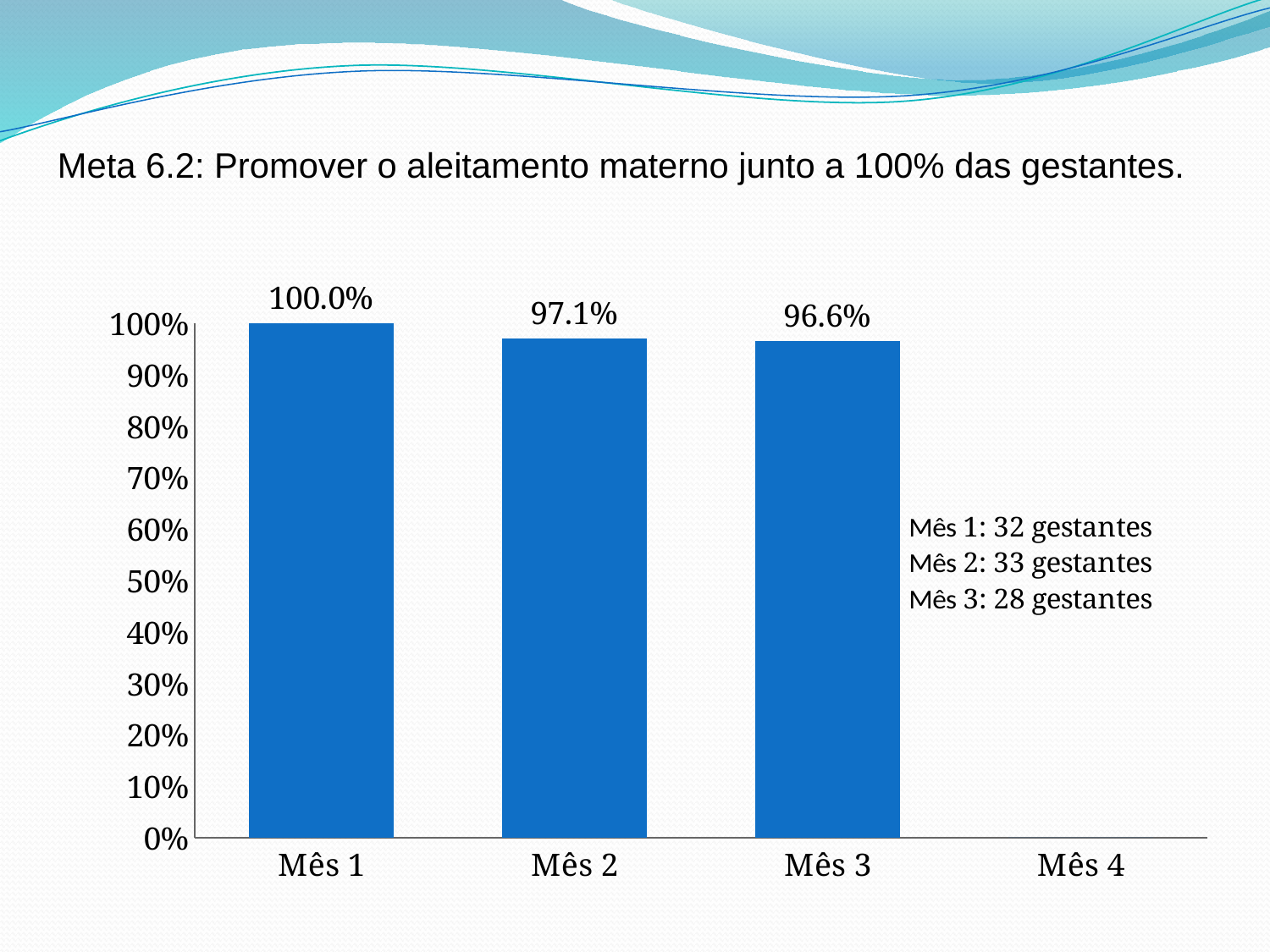
Among the months with a plotted bar, which has the lowest value? Mês 3 What kind of chart is shown on the slide? Bar chart What is the value for Mês 2? 97.1% Which month has the highest value? Mês 1 What is the difference between the values for Mês 2 and Mês 3? 0.5% How many category labels are shown on the x axis? 4 Which is larger, the value for Mês 1 or the value for Mês 2? Mês 1 What is the value for Mês 3? 96.6% What is the difference between the values for Mês 1 and Mês 3? 3.4% How many bars are plotted in the chart? 3 Do the values rise or fall from Mês 1 to Mês 3? Fall What is the value for Mês 1? 100.0%